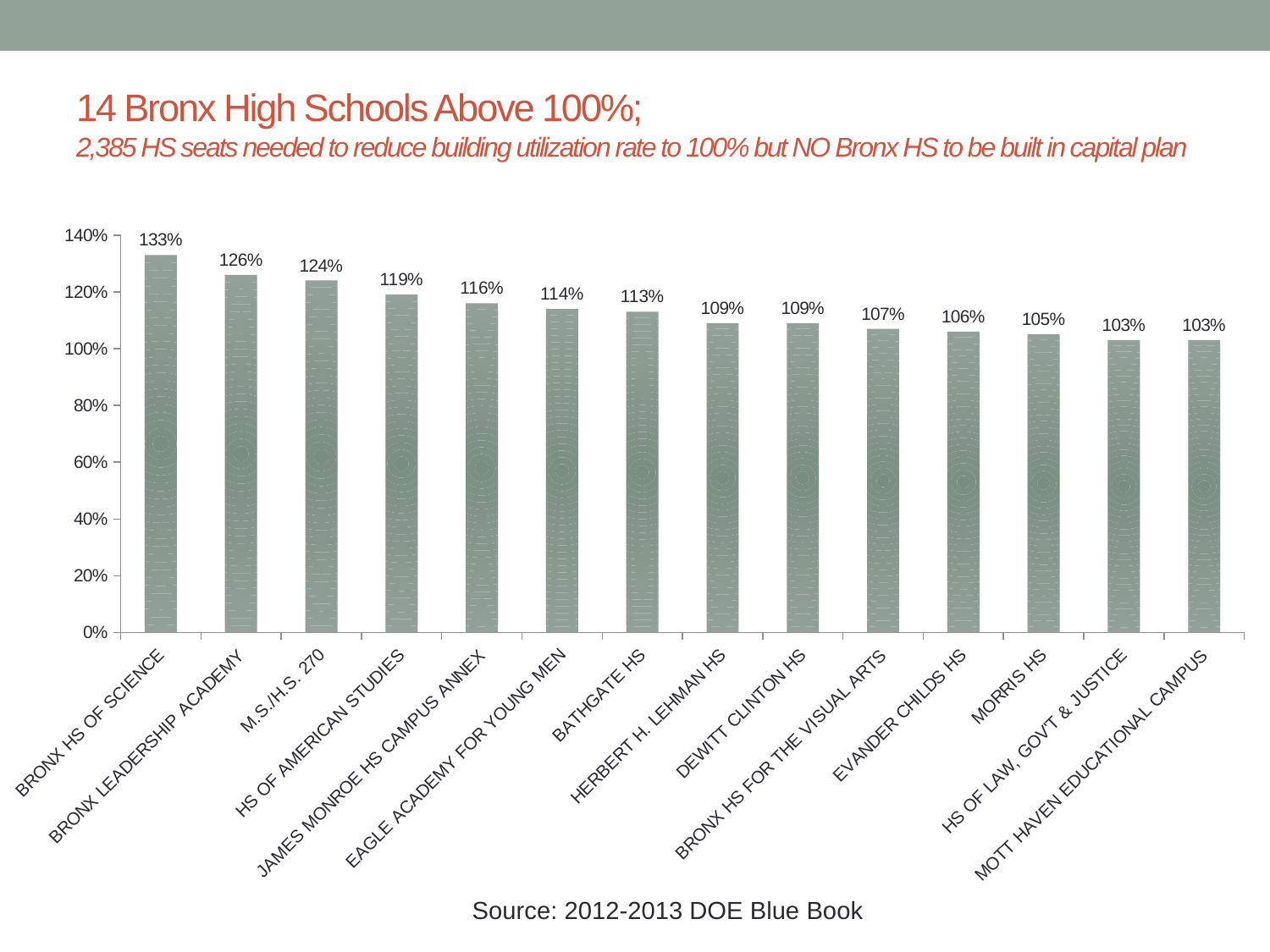
What kind of chart is shown on the slide? Bar chart What is the difference between the values for Bronx HS of Science and Mott Haven Educational Campus? 30% Is the value for Morris HS greater or less than 100%? greater Which school has the highest utilization rate on the chart? Bronx HS of Science What source is cited below the chart? 2012-2013 DOE Blue Book What is the utilization rate shown for Bronx HS of Science? 133% What is the value shown for Bathgate HS? 113% What is the difference between the values for Bronx Leadership Academy and M.S./H.S. 270? 2% How many schools are shown on the chart? 14 Which has a higher value, HS of American Studies or Eagle Academy for Young Men? HS of American Studies Do the values rise or fall from left to right across the chart? Fall What is the value shown for Evander Childs HS? 106%